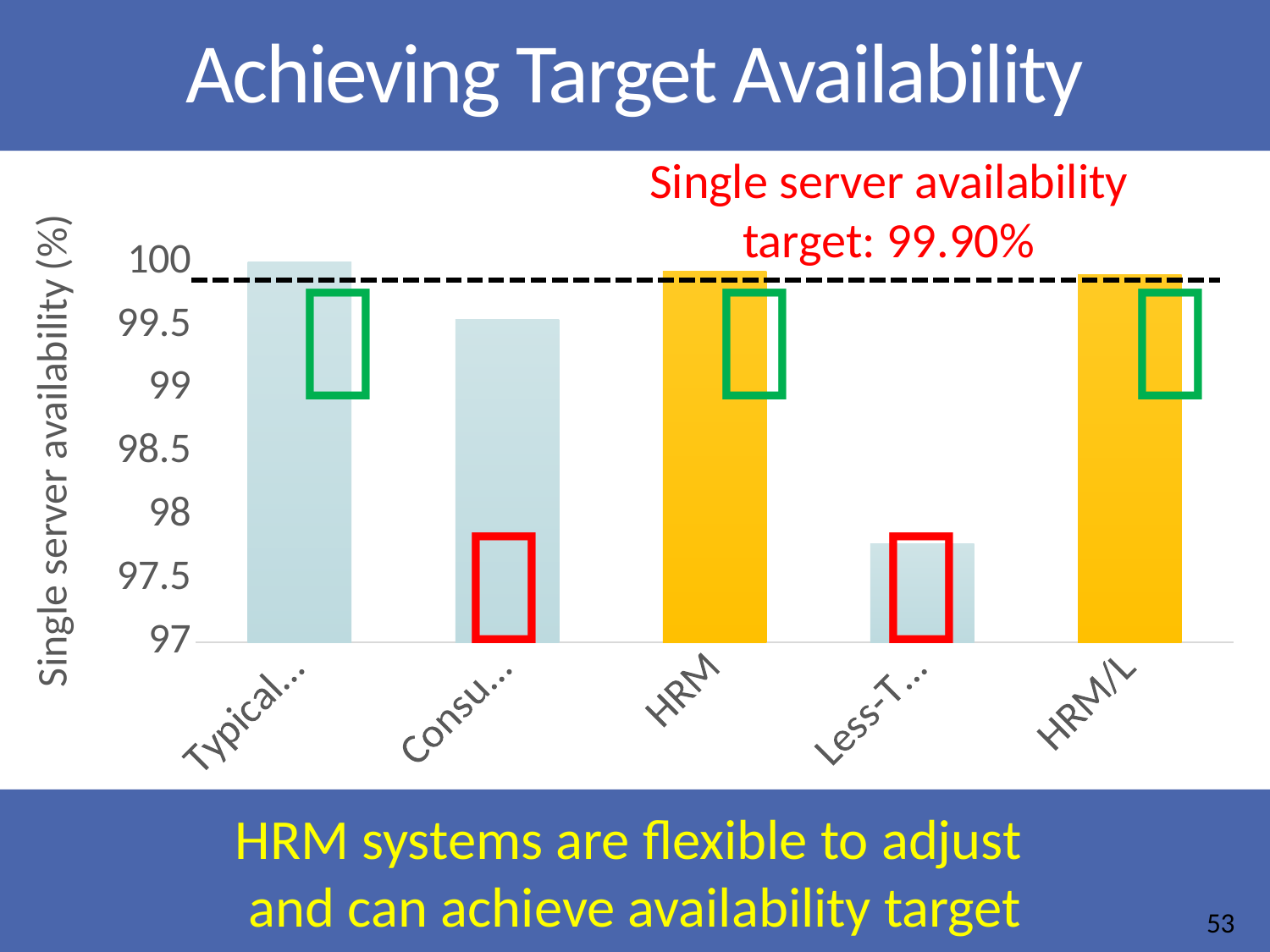
How many bars (categories) does the chart show? 5 Which bar has the lowest value? the fourth bar from the left Is the value for HRM greater or less than 99? greater Is the value of the fourth bar from the left greater or less than 98? less What kind of chart is shown on the slide? bar chart Which is larger, the value for HRM or the value of the fourth bar from the left? HRM Is the value for HRM greater or less than 99.5? greater What is the lowest value shown on the vertical axis? 97 What is the label of the vertical axis? Single server availability (%) What single server availability target is stated on the slide? 99.90%